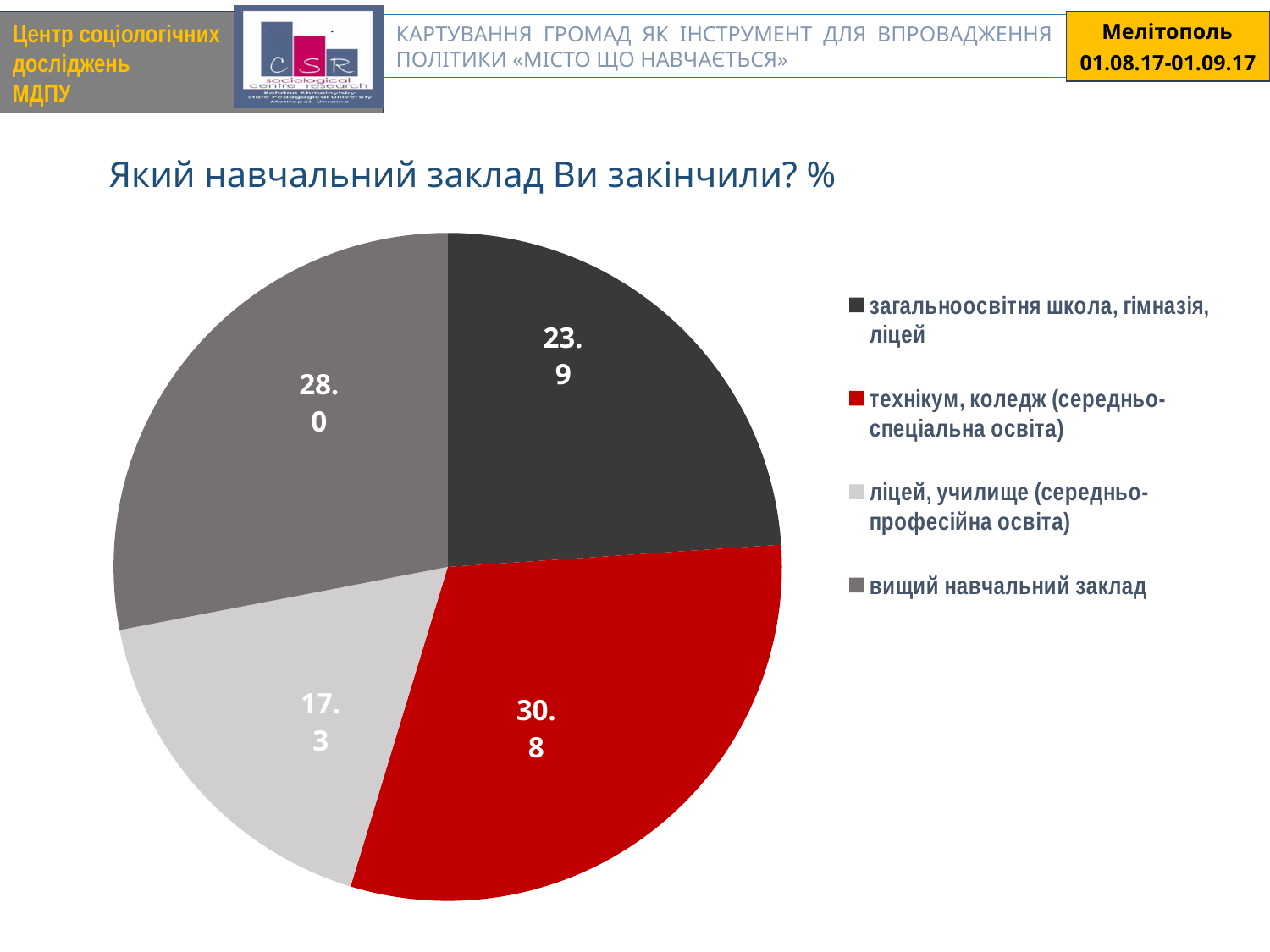
What is the value for «технікум, коледж (середньо-спеціальна освіта)»? 30.8 What type of chart is shown on the slide? pie chart Which category has the largest share of the pie? технікум, коледж (середньо-спеціальна освіта) What is the value for «загальноосвітня школа, гімназія, ліцей»? 23.9 What is the value for «вищий навчальний заклад»? 28.0 How many categories does the pie chart have? 4 What is the title of the chart? Який навчальний заклад Ви закінчили? % Which is larger: the value for «вищий навчальний заклад» or for «загальноосвітня школа, гімназія, ліцей»? вищий навчальний заклад What is the difference between the values for «технікум, коледж» and «ліцей, училище»? 13.5 Which category has the smallest share of the pie? ліцей, училище (середньо-професійна освіта) What is the value for «ліцей, училище (середньо-професійна освіта)»? 17.3 What colour is the slice for «технікум, коледж (середньо-спеціальна освіта)»? red